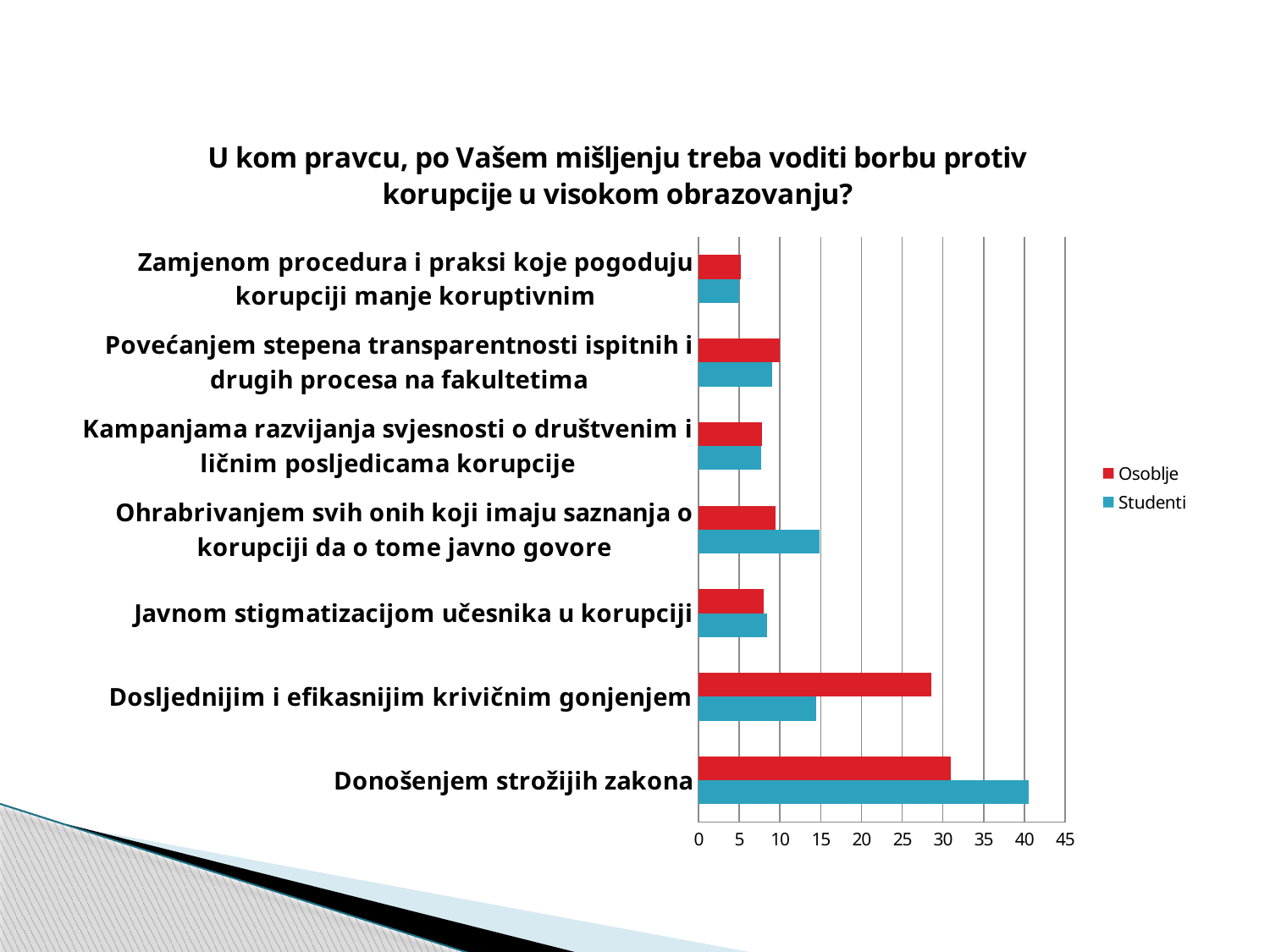
Which category has the lowest value for Osoblje? Zamjenom procedura i praksi koje pogoduju korupciji manje koruptivnim For 'Ohrabrivanjem svih onih koji imaju saznanja o korupciji da o tome javno govore', which series has the larger value, Osoblje or Studenti? Studenti Is the Osoblje value for 'Dosljednijim i efikasnijim krivičnim gonjenjem' greater or less than 25? greater Which category has the highest value for Studenti? Donošenjem strožijih zakona For 'Donošenjem strožijih zakona', which series has the larger value, Osoblje or Studenti? Studenti For 'Dosljednijim i efikasnijim krivičnim gonjenjem', which series has the larger value, Osoblje or Studenti? Osoblje How many series does the legend list? 2 Which series is shown in red in the legend? Osoblje Which category has the highest value for Osoblje? Donošenjem strožijih zakona What kind of chart is shown on the slide? bar chart How many categories are shown on the chart? 7 Is the Studenti value for 'Donošenjem strožijih zakona' greater or less than 35? greater